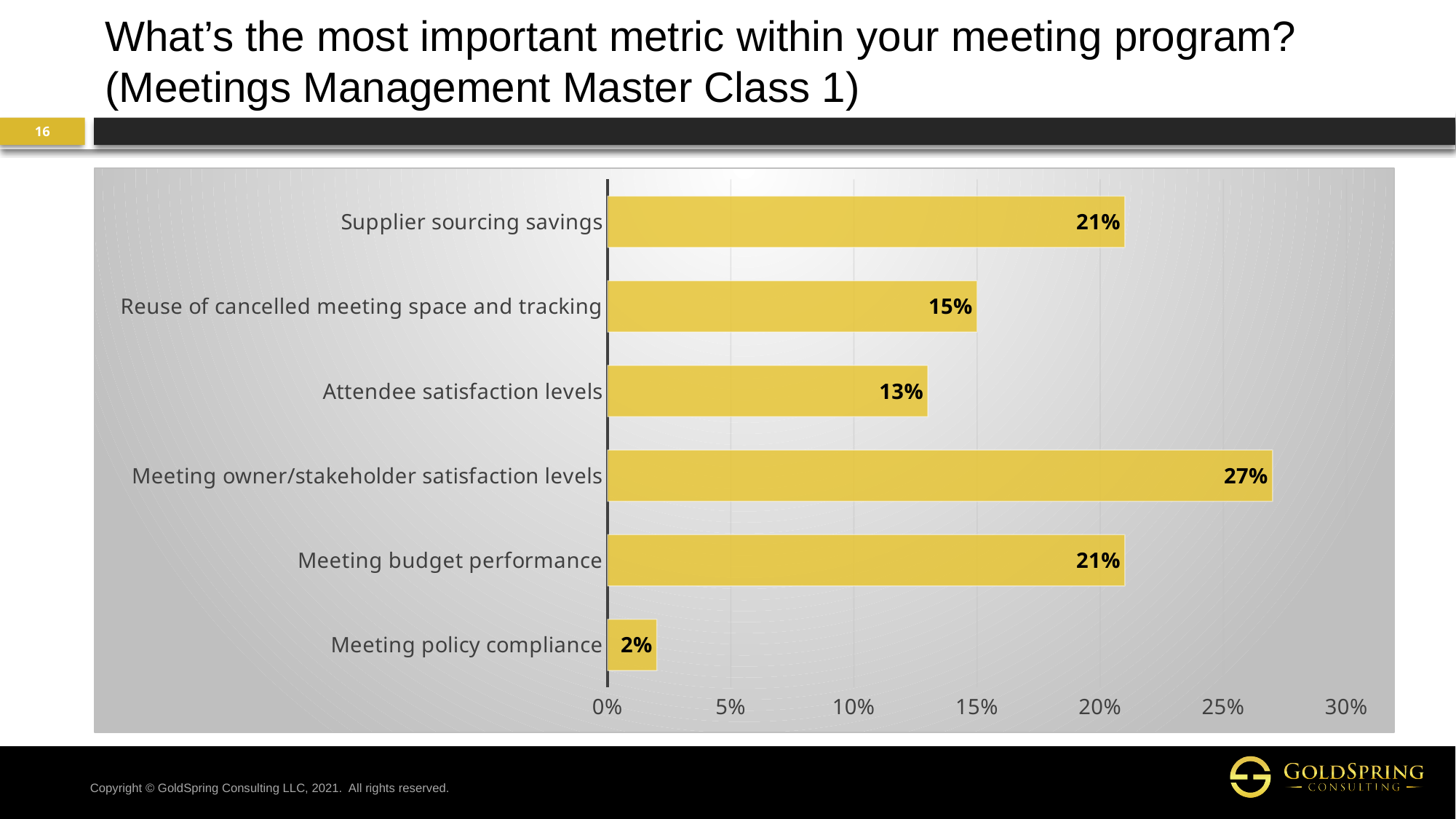
How many metrics are shown in the chart? 6 What percentage is shown for Meeting policy compliance? 2% What percentage is shown for Supplier sourcing savings? 21% What percentage is shown for Reuse of cancelled meeting space and tracking? 15% Which metric has the highest percentage? Meeting owner/stakeholder satisfaction levels What is the difference between Reuse of cancelled meeting space and tracking and Attendee satisfaction levels? 2% Which metric has the lowest percentage? Meeting policy compliance What is the maximum value shown on the horizontal axis? 30% What kind of chart is shown on the slide? Bar chart Which is larger, Reuse of cancelled meeting space and tracking or Attendee satisfaction levels? Reuse of cancelled meeting space and tracking What percentage is shown for Attendee satisfaction levels? 13% What is the difference between Meeting owner/stakeholder satisfaction levels and Meeting budget performance? 6%